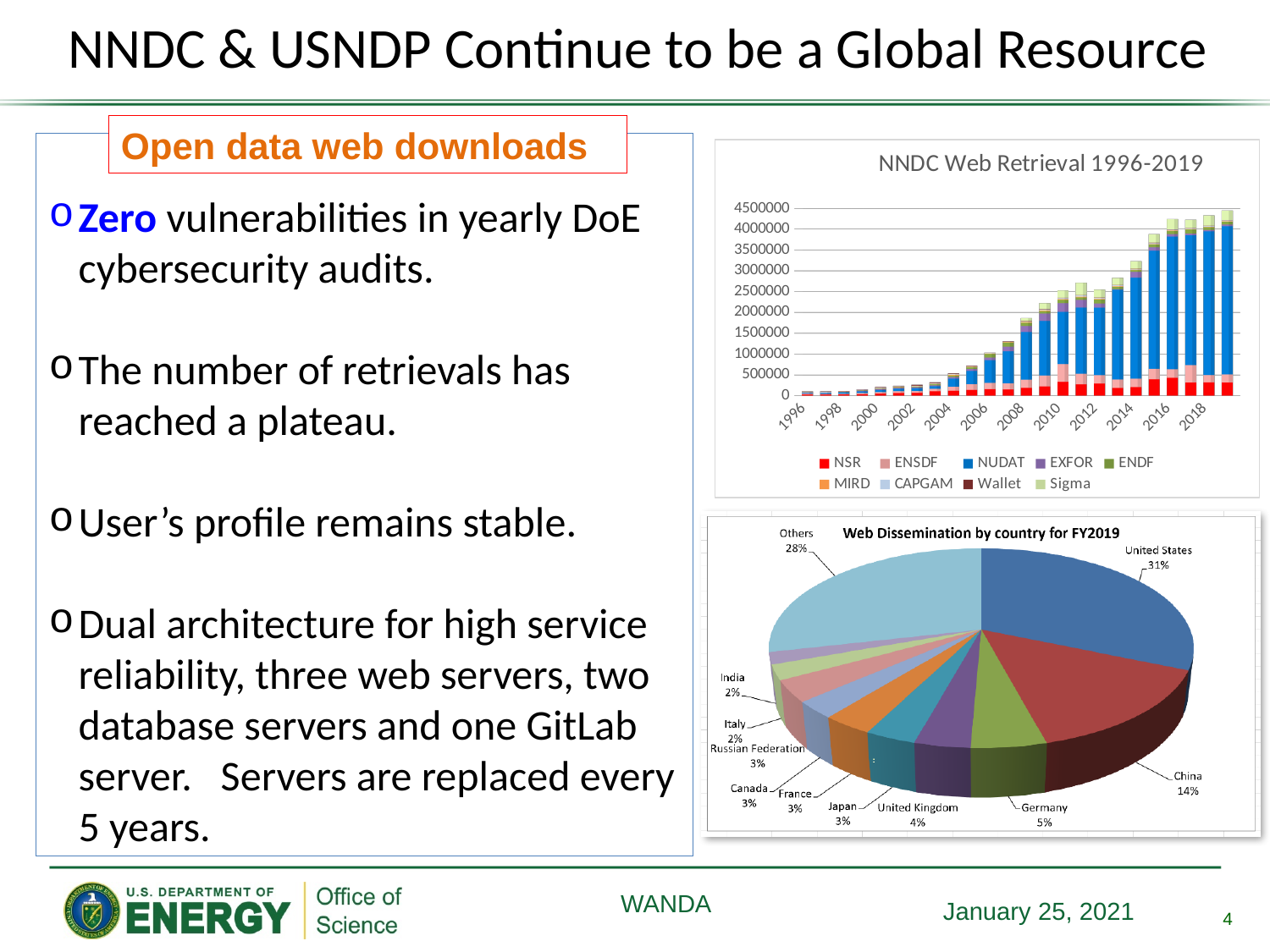
In the 'NNDC Web Retrieval 1996-2019' chart, is the total for 2019 greater or less than 4000000? greater In the 'NNDC Web Retrieval 1996-2019' chart, which series is shown in red in the legend? NSR What type of chart is 'Web Dissemination by country for FY2019'? pie chart How many series does the legend of the 'NNDC Web Retrieval 1996-2019' chart list? 9 In the 'NNDC Web Retrieval 1996-2019' chart, do the total retrievals generally rise or fall from 1996 to 2019? rise In the 'Web Dissemination by country for FY2019' pie chart, what share does the United States have? 31% In the 'Web Dissemination by country for FY2019' pie chart, which named country has the largest share? United States In the 'Web Dissemination by country for FY2019' pie chart, what share does China have? 14% What type of chart is the 'NNDC Web Retrieval 1996-2019' chart? stacked bar chart In the 'NNDC Web Retrieval 1996-2019' chart, is the total for 2000 greater or less than 500000? less In the 'Web Dissemination by country for FY2019' pie chart, what is the difference between the United States share and the China share? 17% In the 'Web Dissemination by country for FY2019' pie chart, which has the larger share, Germany or the United Kingdom? Germany